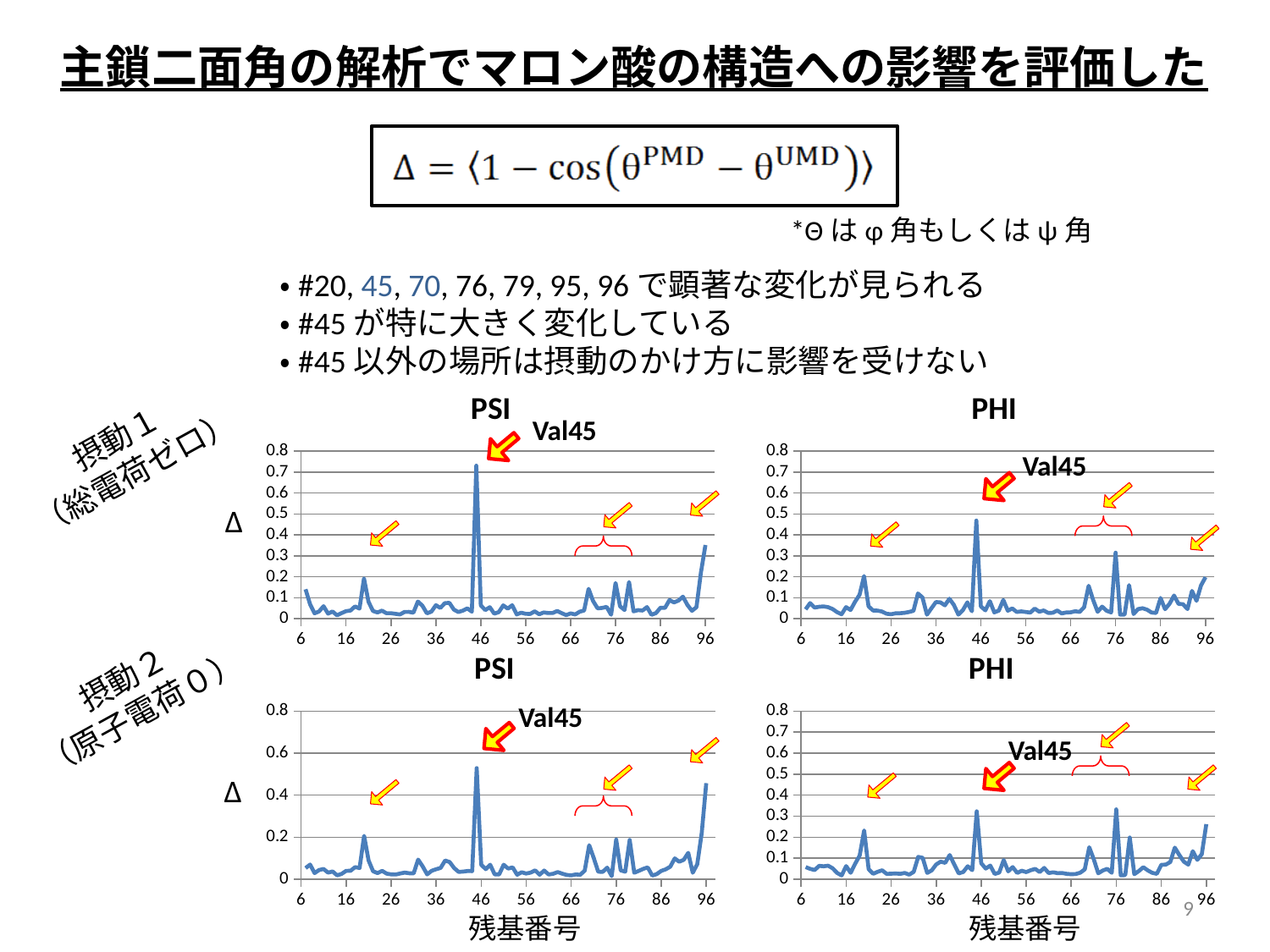
In the bottom-right PHI chart, is the Δ value at Val45 greater or less than 0.4? less In the top-right PHI chart, is the Δ value at Val45 greater or less than 0.4? greater In the top-left PSI chart, which residue has the highest Δ value? Val45 In the top-left PSI chart, is the Δ value at Val45 greater or less than 0.6? greater In the top-right PHI chart, which residue has the highest Δ value? Val45 What kind of chart is the top-left PSI chart? line chart What is the x-axis label of the bottom charts? 残基番号 What is the highest tick value shown on the y-axis of the top-left PSI chart? 0.8 How many charts are shown on the slide? 4 In the top-left PSI chart, which has the larger Δ value: residue 45 or residue 20? residue 45